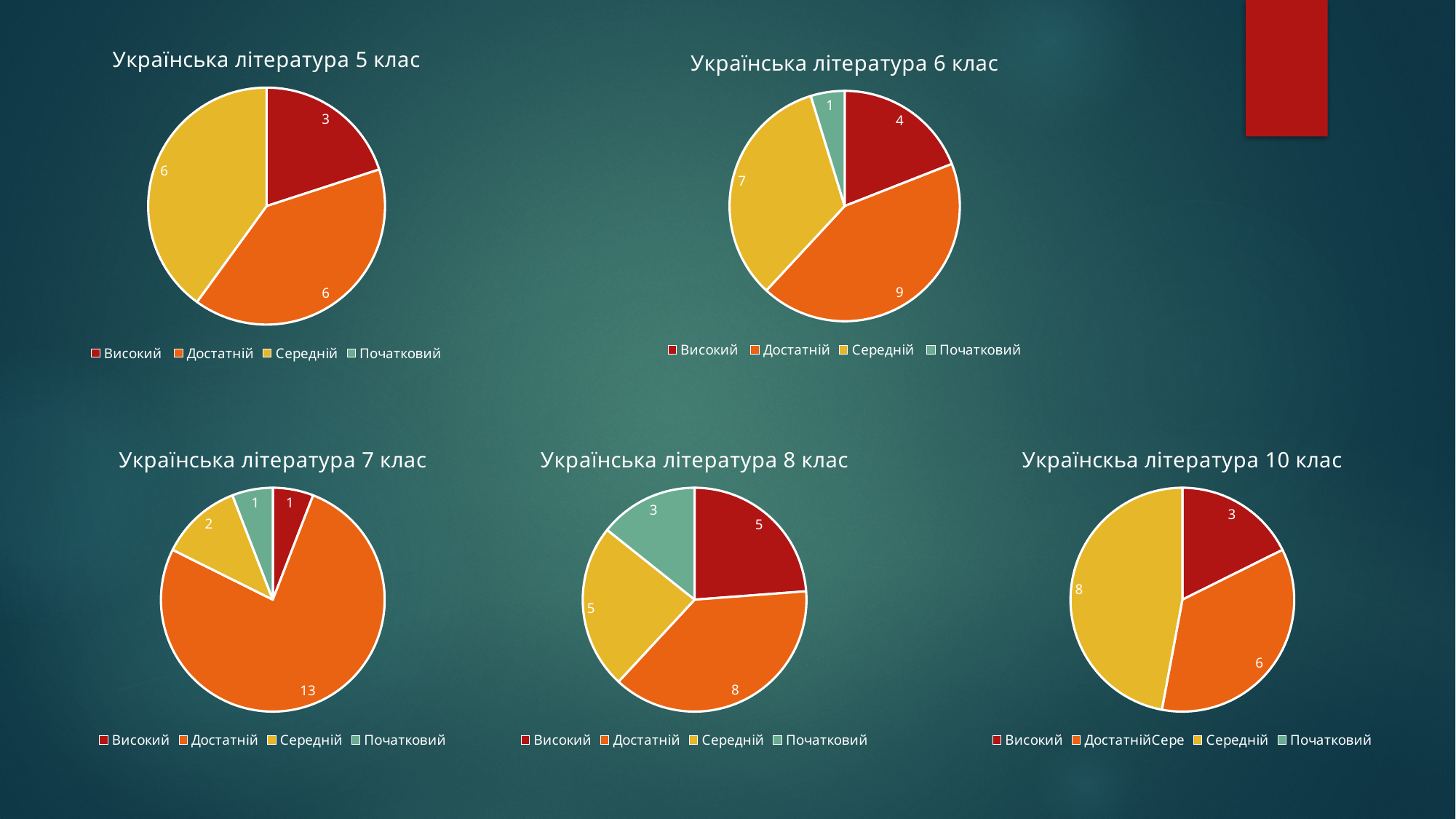
In the chart titled "Українська література 8 клас", what is the value for Початковий? 3 In the chart titled "Українська література 8 клас", which is larger, Достатній or Високий? Достатній How many pie charts are shown on the slide? 5 In the chart titled "Українська література 7 клас", what is the difference between Достатній and Середній? 11 What type of chart is used for "Українська література 6 клас"? Pie chart How many series does the legend list in the chart titled "Українська література 8 клас"? 4 In the chart titled "Українскьа література 10 клас", what is the value for Середній? 8 In the chart titled "Українська література 5 клас", what is the value for Високий? 3 In the chart titled "Українська література 6 клас", what is the value for Достатній? 9 In the chart titled "Українська література 6 клас", which category has the lowest value? Початковий In the chart titled "Українскьа література 10 клас", what share of the pie does Високий represent? 3 of 17 In the chart titled "Українська література 7 клас", which category has the highest value? Достатній